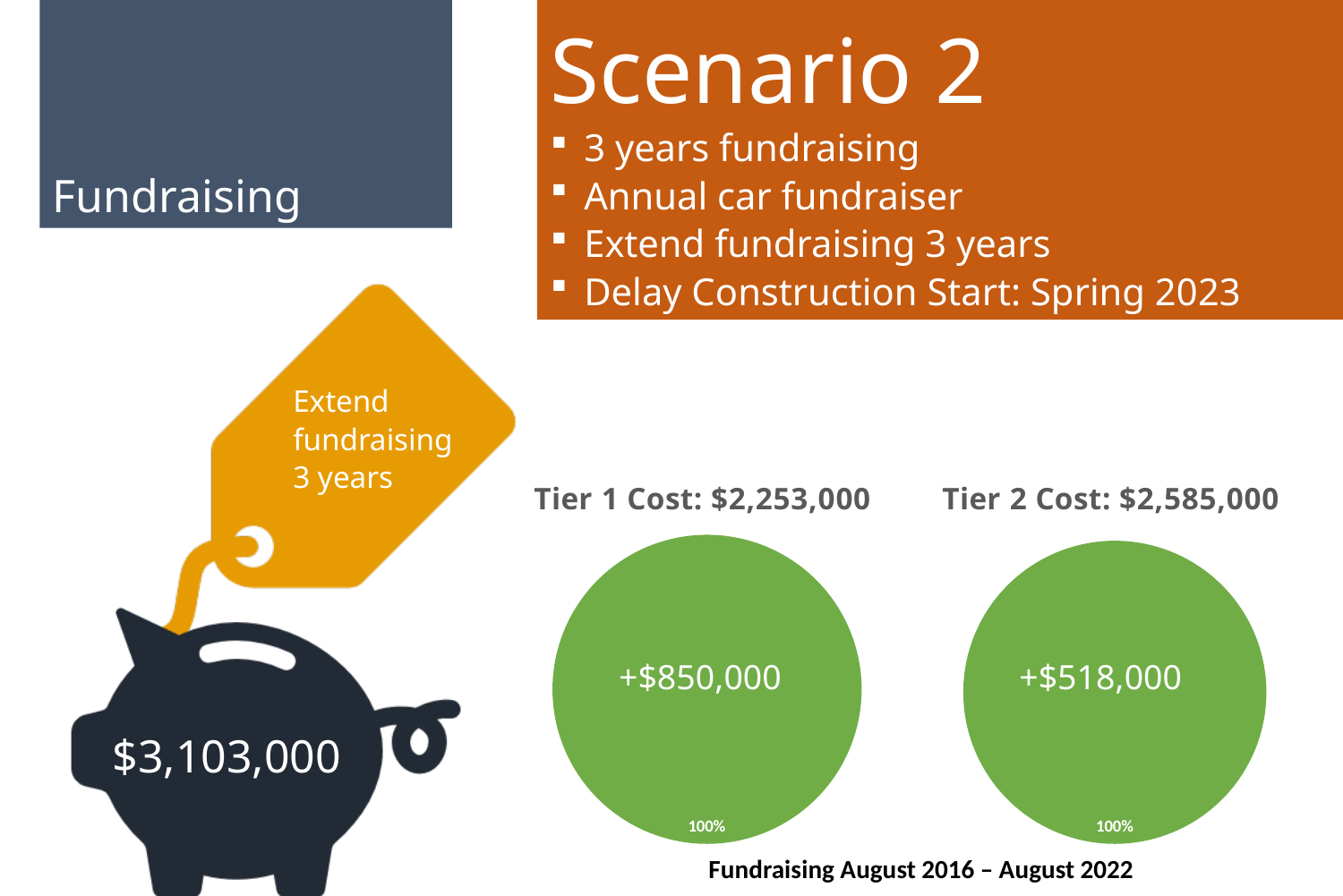
In the Tier 1 Cost pie chart, what dollar amount is printed in the centre of the pie? +$850,000 What is the Tier 2 cost stated in the heading above the right-hand pie chart? $2,585,000 Which pie chart shows the larger dollar amount, the Tier 1 Cost chart or the Tier 2 Cost chart? Tier 1 Cost In the Tier 2 Cost pie chart, what dollar amount is printed in the centre of the pie? +$518,000 What is the difference between the amount shown in the Tier 1 Cost pie chart (+$850,000) and the amount shown in the Tier 2 Cost pie chart (+$518,000)? $332,000 What is the heading printed above the left-hand pie chart? Tier 1 Cost: $2,253,000 How many pie charts are shown on the slide? 2 What colour are the two pie charts on the slide? green In the Tier 1 Cost pie chart, how many slices does the pie have? 1 In the Tier 2 Cost pie chart, what percentage label is printed on the pie? 100% What kind of chart is shown under the heading "Tier 1 Cost: $2,253,000"? pie chart What is the difference between the Tier 2 cost ($2,585,000) and the Tier 1 cost ($2,253,000) shown in the chart headings? $332,000